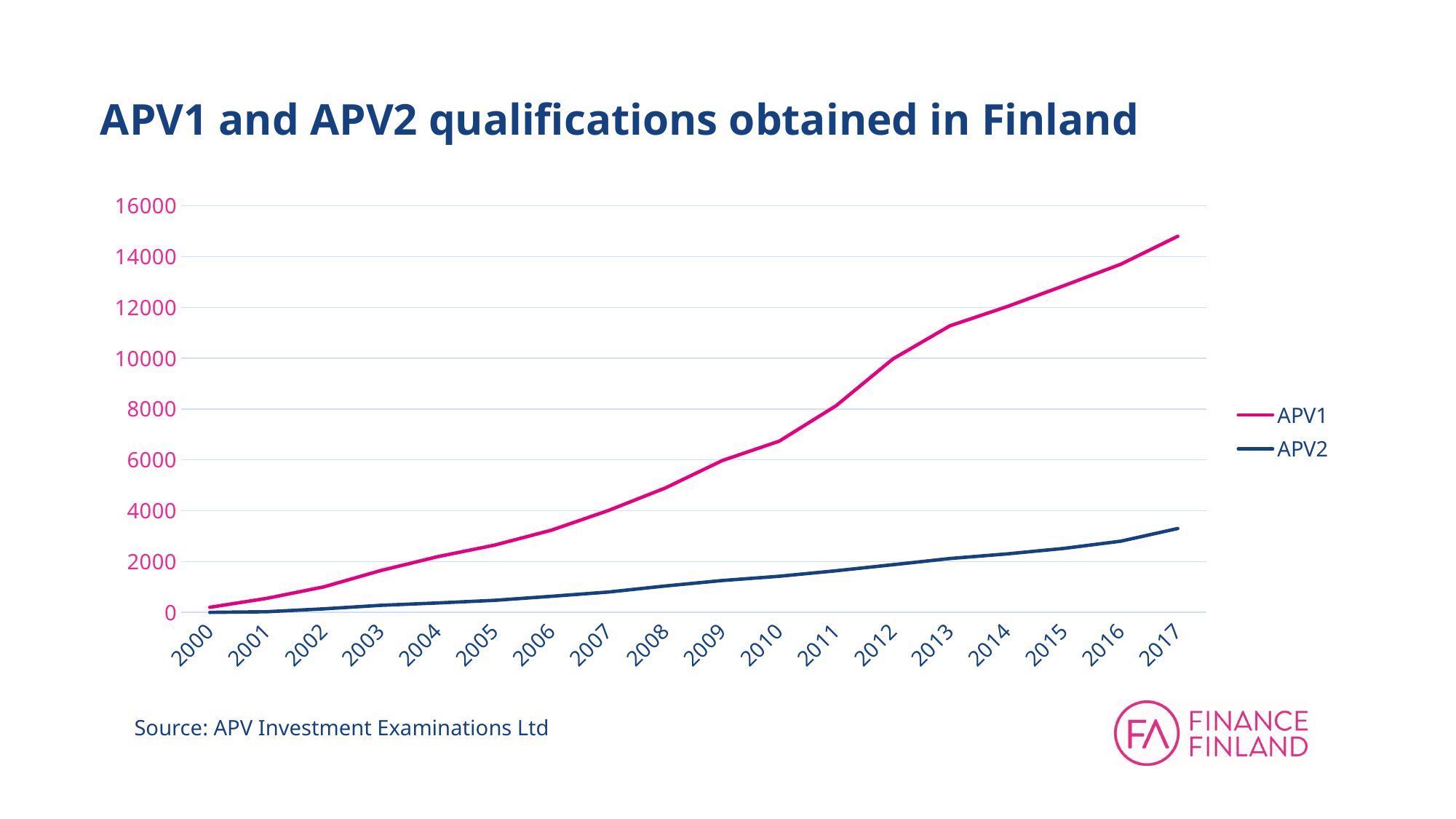
In which year is the APV1 series at its lowest? 2000 Do the APV1 values rise or fall from 2000 to 2017? Rise What kind of chart is shown on the slide? Line chart Is the value for APV1 in 2013 greater or less than 10000? greater Is the value for APV1 in 2017 greater or less than 14000? greater Is the value for APV2 in 2005 greater or less than 1000? less Which series has the larger value in 2017, APV1 or APV2? APV1 How many years are plotted along the x axis? 18 In which year is the APV1 series at its highest? 2017 What is the title of the chart? APV1 and APV2 qualifications obtained in Finland How many series does the legend list? 2